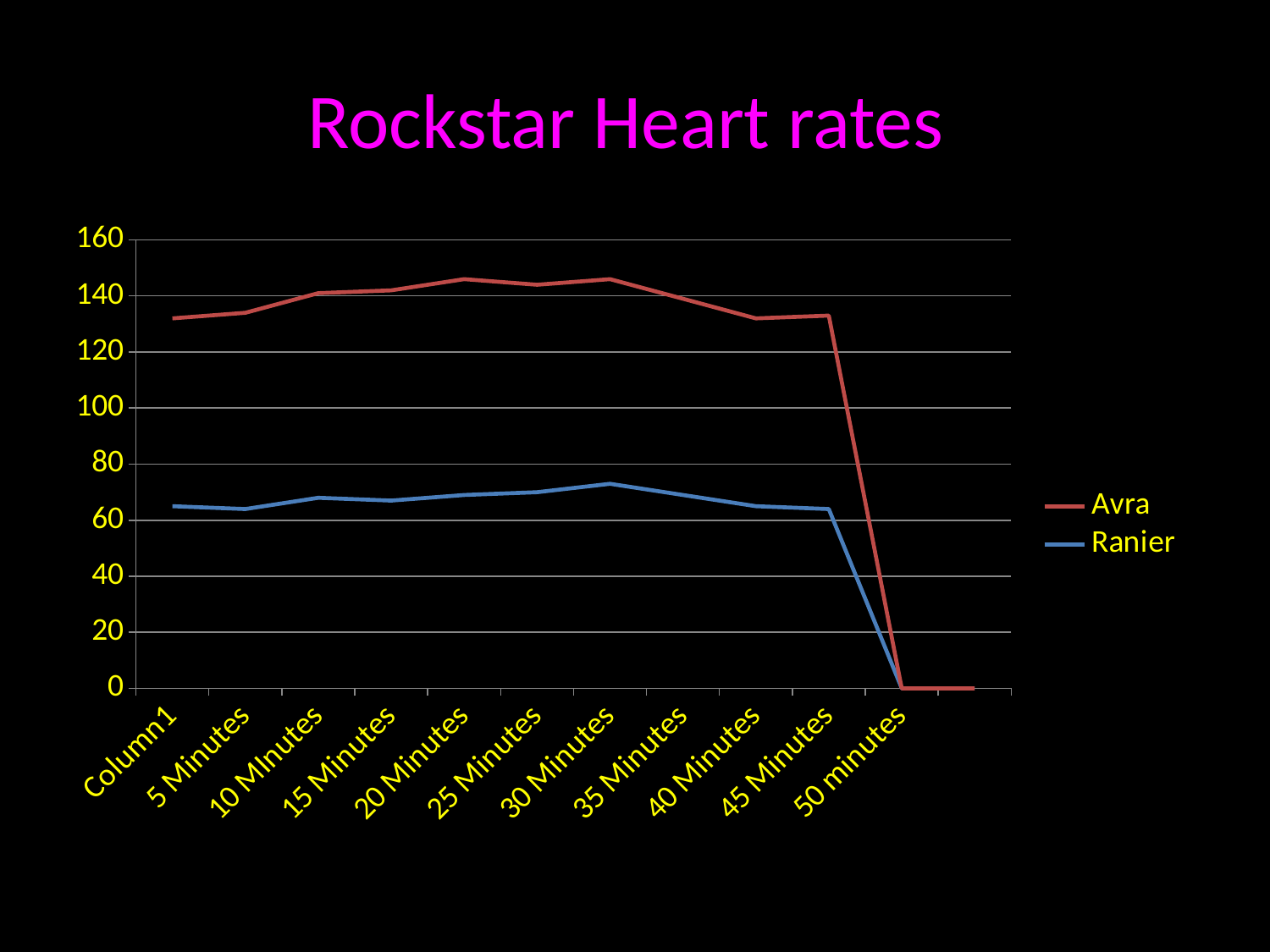
What is the title of the chart? Rockstar Heart rates Is the value for Ranier at 30 Minutes greater or less than 80? less Which series is drawn with the red line? Avra What is the value for Ranier at 50 minutes? 0 How many series does the legend list? 2 What kind of chart is shown on the slide? line chart What is the value for Avra at 50 minutes? 0 At which x-axis category does Ranier reach its highest value? 30 Minutes At 20 Minutes, which series has the larger value, Avra or Ranier? Avra Is the value for Avra at Column1 greater or less than 140? less Does the Avra line rise or fall from 30 Minutes to 50 minutes? fall Is the value for Avra at 20 Minutes greater or less than 140? greater